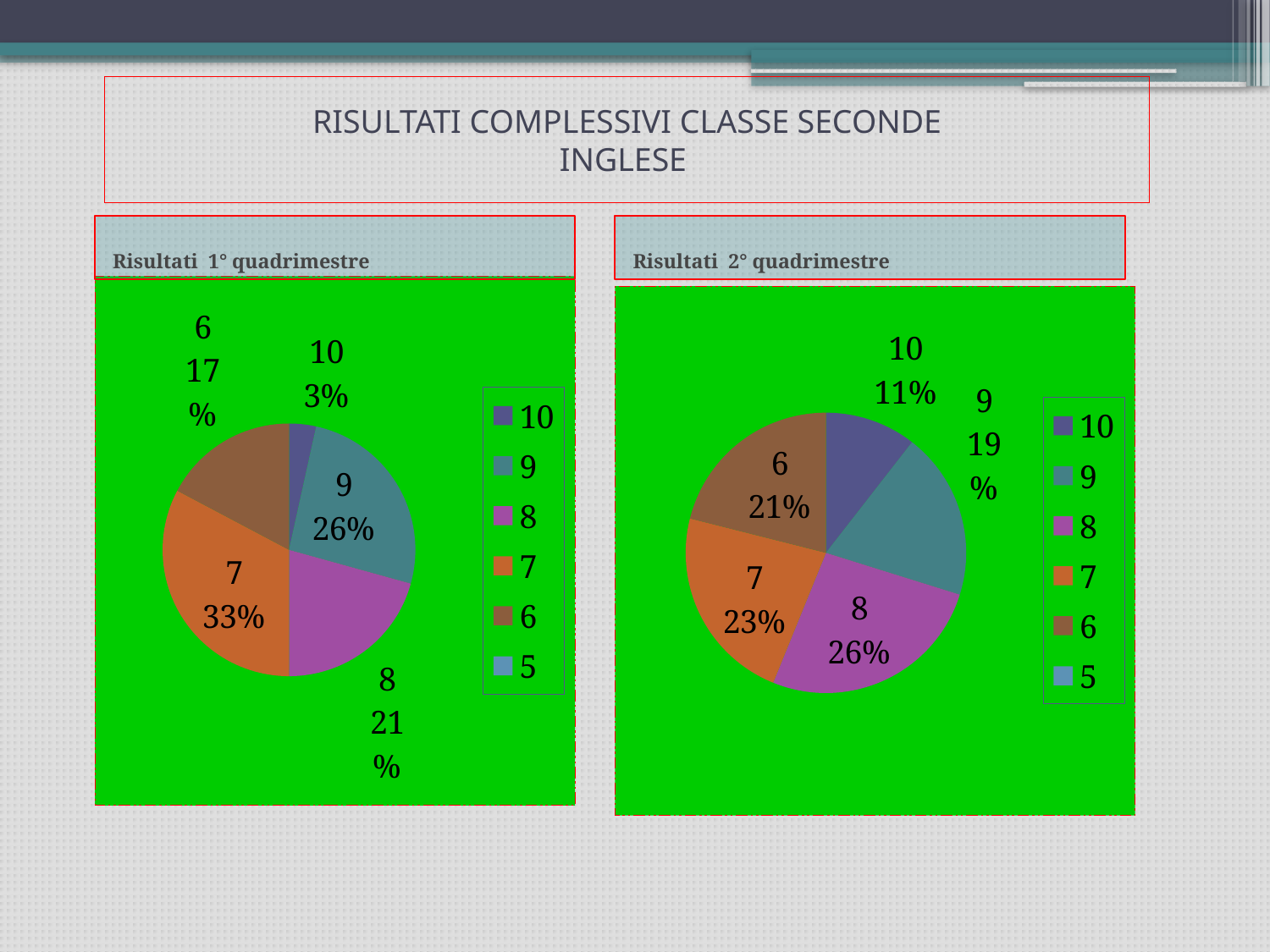
In the 'Risultati 2° quadrimestre' chart, which is larger, the slice for grade 7 or the slice for grade 9? 7 In the 'Risultati 2° quadrimestre' chart, which grade has the smallest labelled slice? 10 How many entries does the legend of the 'Risultati 1° quadrimestre' chart list? 6 In the 'Risultati 1° quadrimestre' chart, which grade has the largest slice? 7 In the 'Risultati 1° quadrimestre' chart, what is the difference between the percentages for grade 9 and grade 6? 9% In the 'Risultati 1° quadrimestre' chart, what share of the pie does grade 7 have? 33% In the 'Risultati 2° quadrimestre' chart, what is the difference between the percentages for grade 7 and grade 10? 12% What type of chart is used for 'Risultati 2° quadrimestre'? Pie chart In the 'Risultati 2° quadrimestre' chart, what percentage is shown for grade 8? 26% In the 'Risultati 1° quadrimestre' chart, which grade has the smallest labelled slice? 10 In the 'Risultati 2° quadrimestre' chart, which grade has the largest slice? 8 In the 'Risultati 1° quadrimestre' chart, what percentage is shown for grade 10? 3%